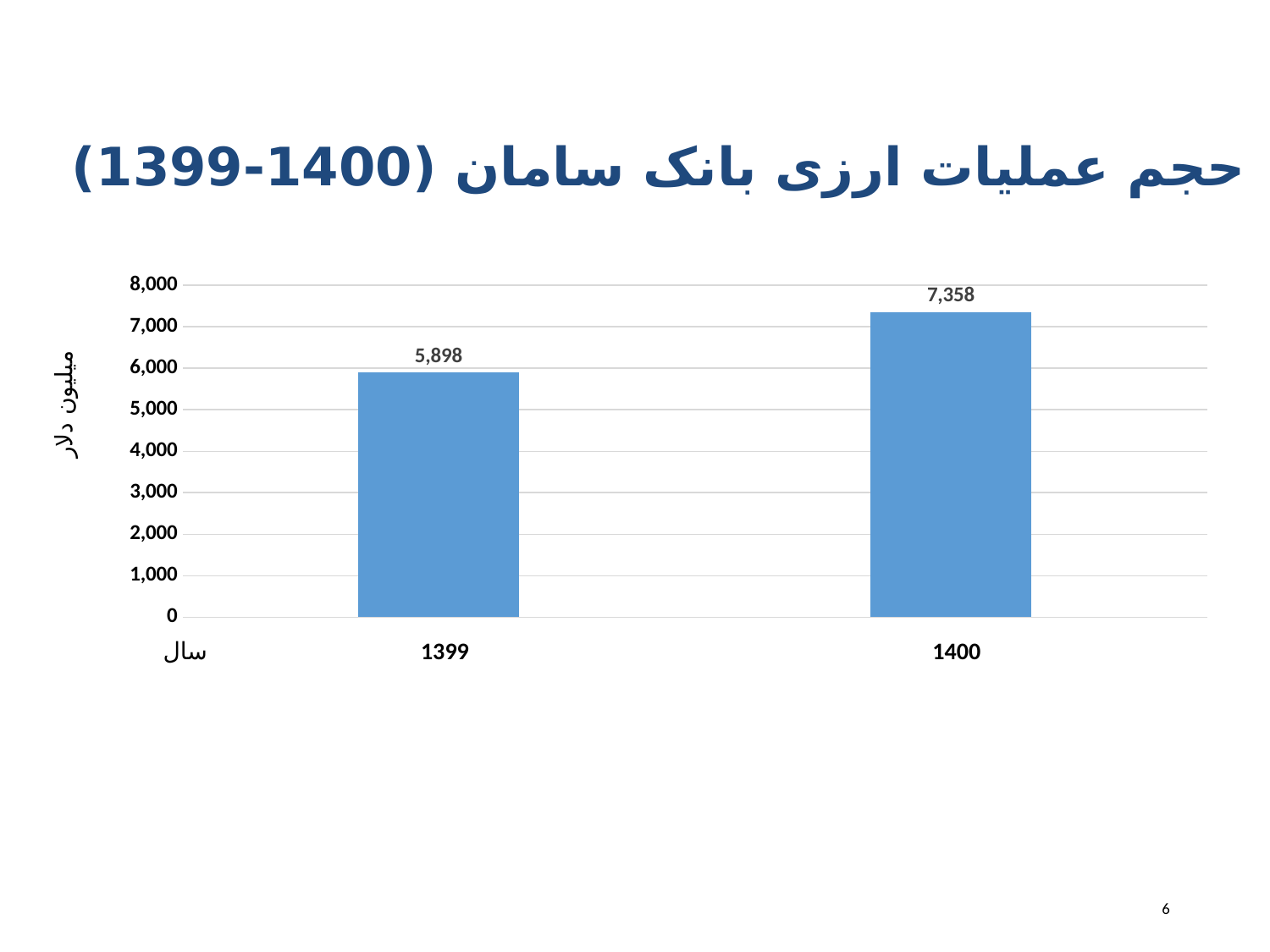
What kind of chart is shown on the slide? bar chart Which is larger, the value for 1399 or the value for 1400? 1400 What is the value for 1400? 7,358 Is the value for 1399 greater or less than 6,000? less What is the value for 1399? 5,898 Is the value for 1400 greater or less than 7,000? greater What is the difference between the values for 1400 and 1399? 1,460 How many bars are shown in the chart? 2 Which year has the lowest value? 1399 Which year has the highest value? 1400 Do the values rise or fall from 1399 to 1400? rise What is the label on the vertical axis of the chart? میلیون دلار